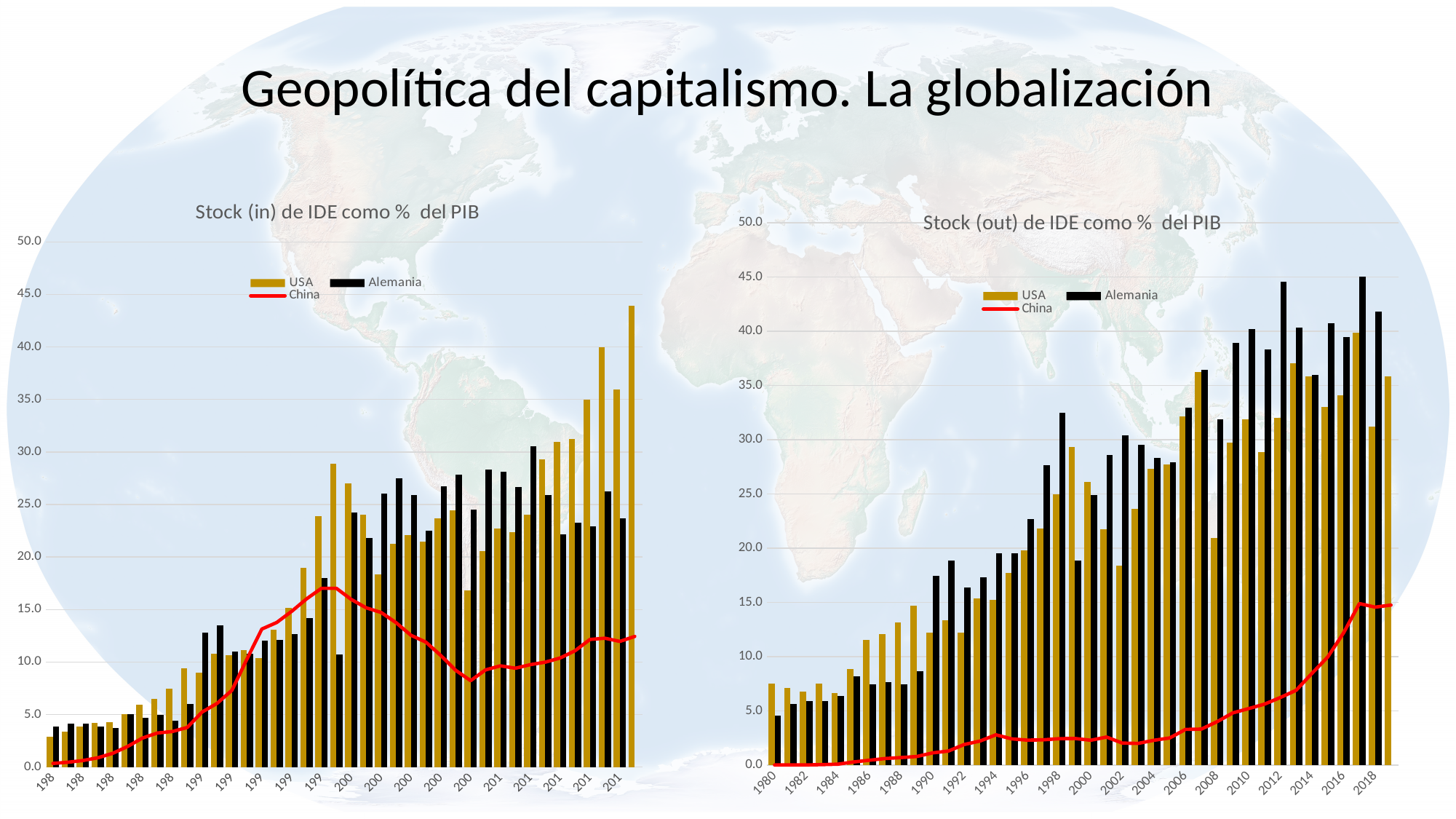
In the 'Stock (out) de IDE como % del PIB' chart, is the value for USA in 1980 greater or less than 5.0? greater In the 'Stock (out) de IDE como % del PIB' chart, which is larger in 1980, USA or Alemania? USA In the 'Stock (out) de IDE como % del PIB' chart, is the value for Alemania in 2018 greater or less than 40.0? greater In the 'Stock (out) de IDE como % del PIB' chart, which series is drawn as a red line? China In the 'Stock (out) de IDE como % del PIB' chart, which series has the lowest value in 1980? China What kind of chart is the 'Stock (out) de IDE como % del PIB' chart? Bar chart with a line series In the 'Stock (out) de IDE como % del PIB' chart, which is larger in 2018, USA or Alemania? Alemania In the 'Stock (out) de IDE como % del PIB' chart, does the China line generally rise or fall from 1980 to 2018? rise In the 'Stock (out) de IDE como % del PIB' chart, is the value for China in 2018 greater or less than 10.0? greater How many series does the legend of the 'Stock (out) de IDE como % del PIB' chart list? 3 What is the title of the chart on the left of the slide? Stock (in) de IDE como % del PIB